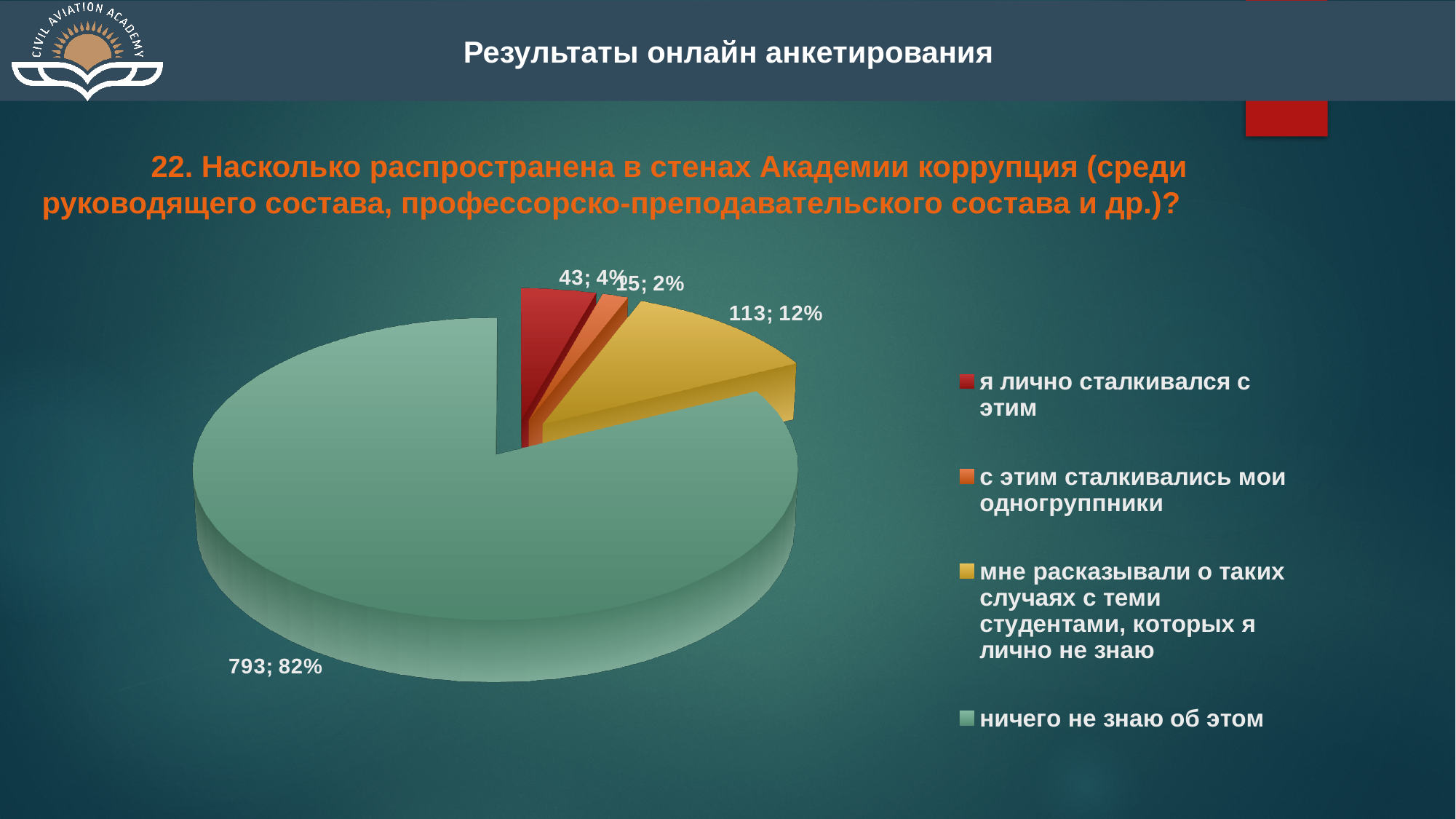
What is the value for "мне расказывали о таких случаях с теми студентами, которых я лично не знаю"? 113; 12% Which is larger, "я лично сталкивался с этим" or "с этим сталкивались мои одногруппники"? я лично сталкивался с этим How many slices does the pie chart have? 4 Which category has the smallest slice? с этим сталкивались мои одногруппники What is the value for "с этим сталкивались мои одногруппники"? 15; 2% What is the difference in count between "ничего не знаю об этом" and "мне расказывали о таких случаях с теми студентами, которых я лично не знаю"? 680 What share of the pie does "ничего не знаю об этом" take? 82% What kind of chart is shown on the slide? pie chart How many entries does the legend list? 4 What is the value for "я лично сталкивался с этим"? 43; 4% What is the value for "ничего не знаю об этом"? 793; 82% Which category has the largest slice? ничего не знаю об этом